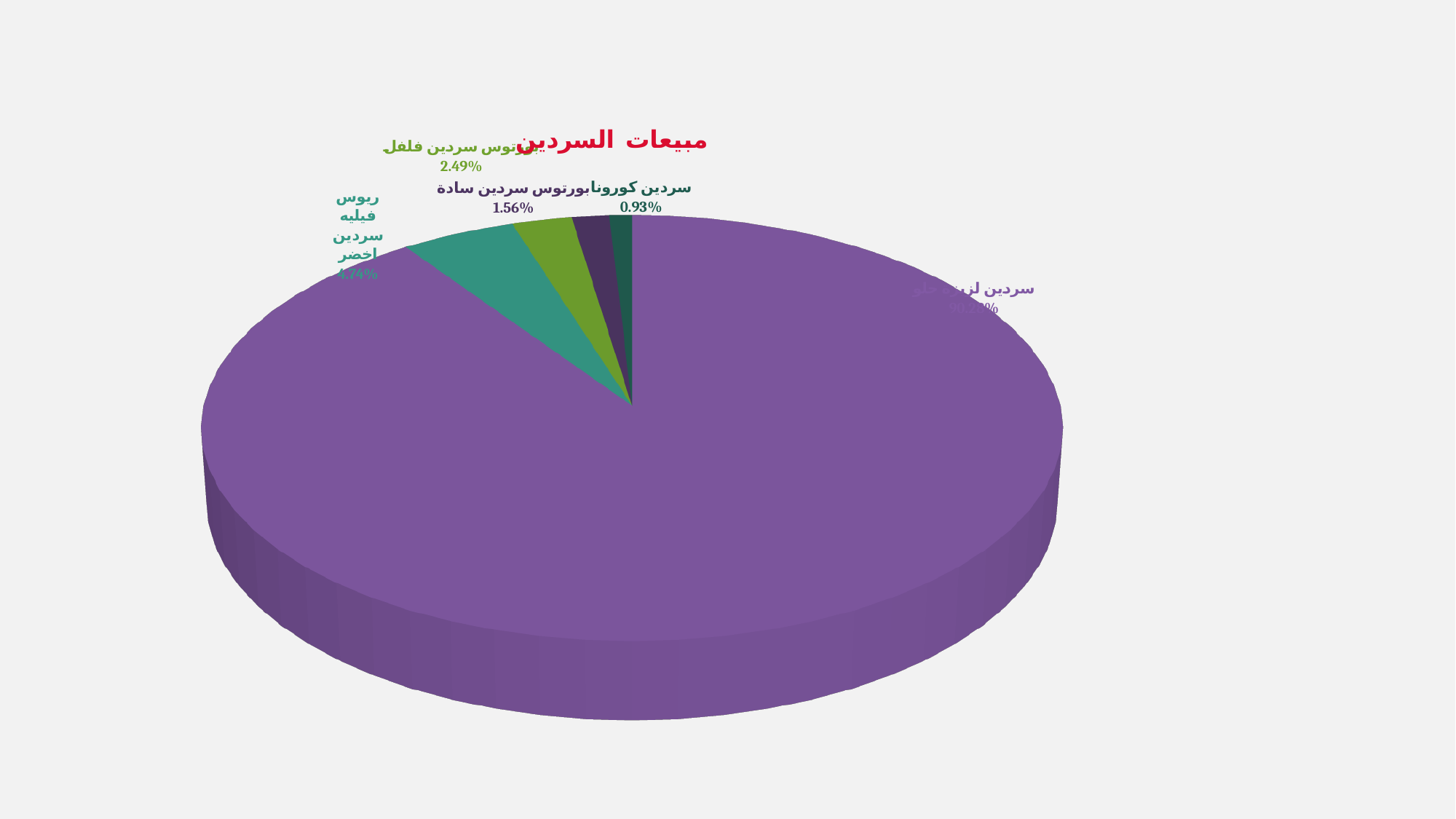
Which category has the largest slice of the pie? سردين لزيزة حلو What is the title of the chart? مبيعات السردين What share of the pie does بورتوس سردين سادة have? 1.56% Which is larger, the share for ربوس فيليه سردين اخضر or the share for بورتوس سردين فلفل? ربوس فيليه سردين اخضر What kind of chart is shown on the slide? pie chart What share of the pie does بورتوس سردين فلفل have? 2.49% What share of the pie does سردين كورونا have? 0.93% Which category has the smallest slice of the pie? سردين كورونا What is the difference between the shares of ربوس فيليه سردين اخضر and بورتوس سردين فلفل? 2.25% How many slices does the pie chart have? 5 What colour is the largest slice of the pie? purple